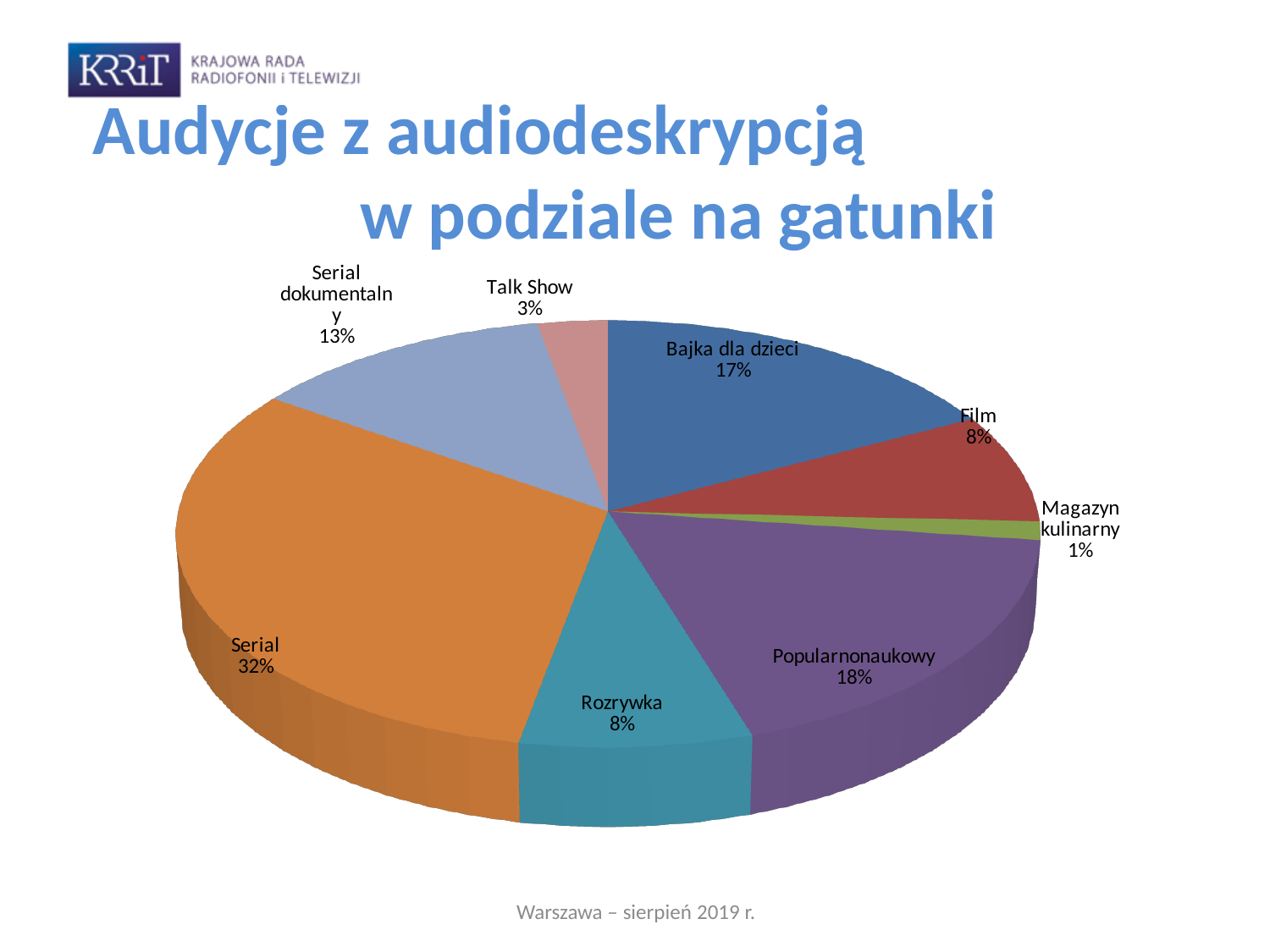
What percentage is shown for Talk Show? 3% What is the title of the chart on the slide? Audycje z audiodeskrypcją w podziale na gatunki What share of the pie does Serial have? 32% What is the value for Serial dokumentalny? 13% Which category has the largest slice of the pie? Serial What is the difference between the shares of Serial and Popularnonaukowy? 14% What is the value shown for Bajka dla dzieci? 17% Which category has the smallest slice of the pie? Magazyn kulinarny How many categories are shown in the pie chart? 8 What percentage is shown for Popularnonaukowy? 18% What kind of chart is shown on the slide? Pie chart Which is larger, the share for Bajka dla dzieci or the share for Serial dokumentalny? Bajka dla dzieci